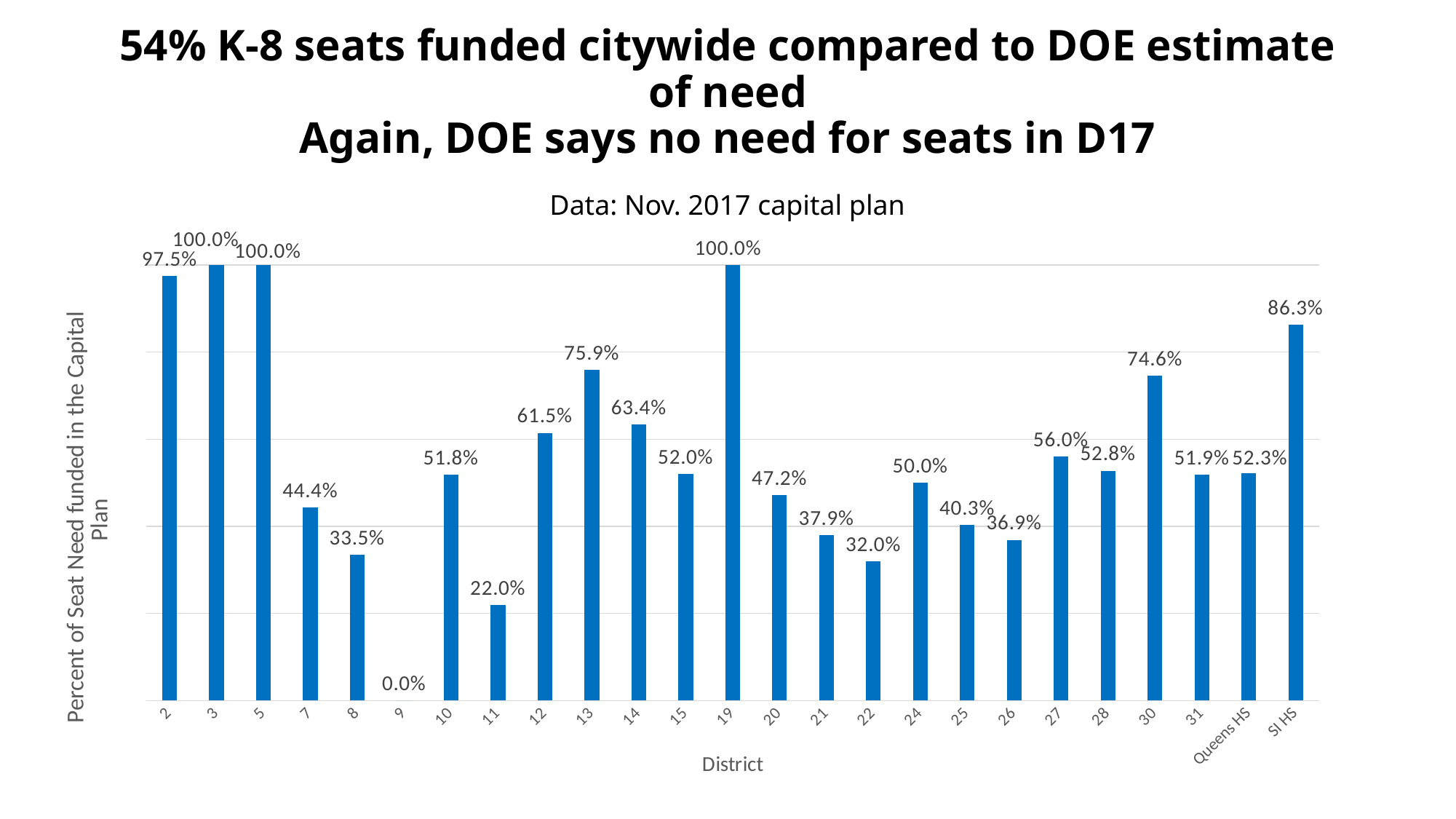
Which has a higher value, District 8 or District 21? District 21 What is the value shown for SI HS? 86.3% What is the value shown for District 11? 22.0% What is the value shown for Queens HS? 52.3% Which has a higher value, District 12 or District 14? District 14 What type of chart is shown on the slide? Bar chart What is the difference between the values for District 2 and District 7? 53.1% How many districts or categories are shown on the x axis? 25 What is the title of the chart? Data: Nov. 2017 capital plan What is the difference between the values for District 30 and District 22? 42.6% What percent of seat need is funded in the capital plan for District 13? 75.9% Which district has the lowest percent of seat need funded? 9